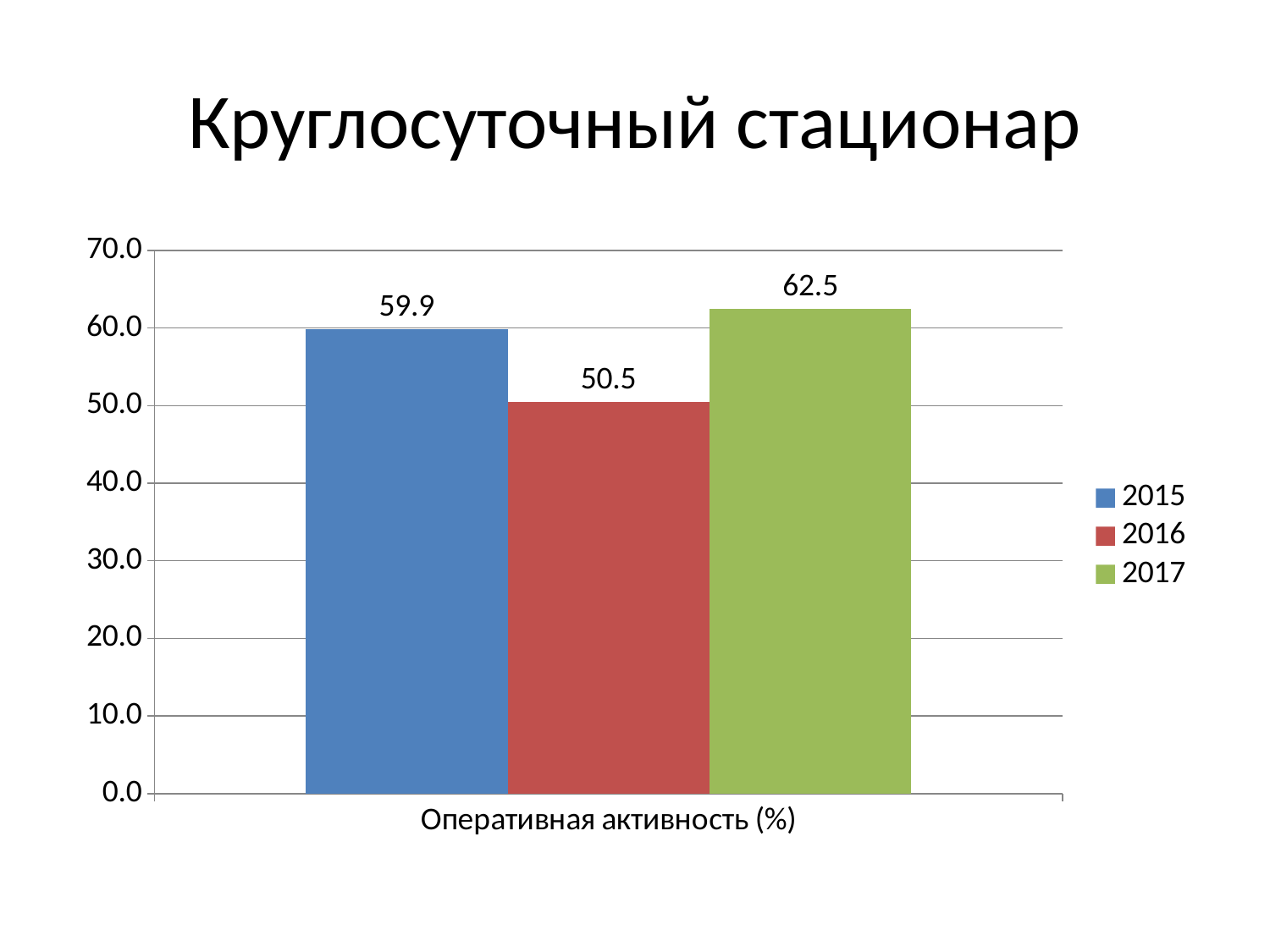
Is the value for 2016 greater or less than 60.0? less What is the value for 2016 in the chart? 50.5 What is the value for 2017 in the chart? 62.5 What is the difference between the values for 2017 and 2016? 12.0 What is the title of the slide? Круглосуточный стационар What kind of chart is shown on the slide? bar chart What is the value for 2015 in the chart? 59.9 What is the difference between the values for 2015 and 2016? 9.4 Which year has the lowest value in the chart? 2016 Which year has the highest value in the chart? 2017 How many series does the legend list? 3 Which is larger, the value for 2015 or the value for 2017? 2017